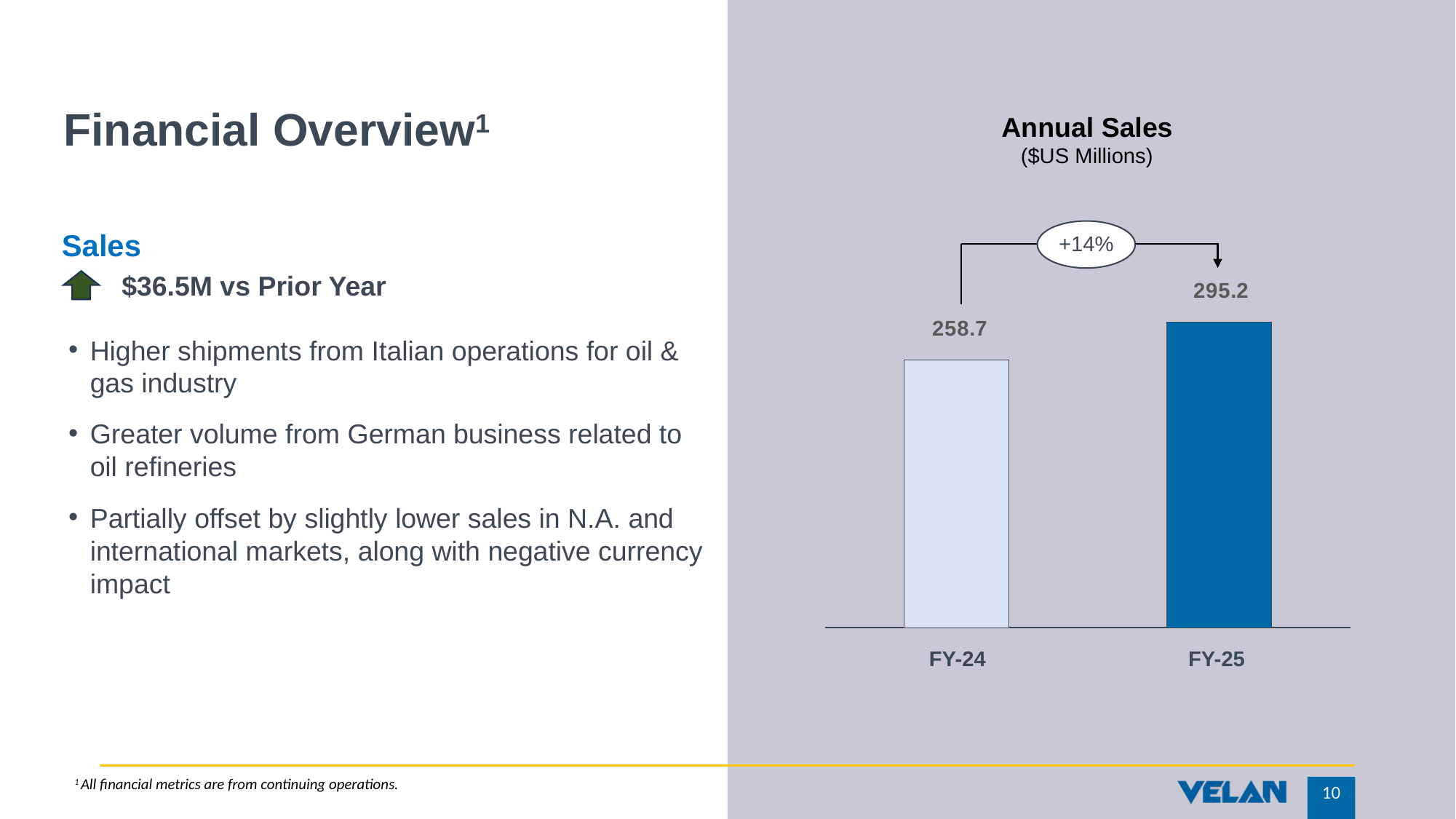
What is the Annual Sales value for FY-25? 295.2 How many years are shown in the Annual Sales chart? 2 What kind of chart is the Annual Sales chart? bar chart Which year has the lower Annual Sales? FY-24 What unit is the Annual Sales chart measured in? $US Millions Do Annual Sales rise or fall from FY-24 to FY-25? rise What is the difference in Annual Sales between FY-25 and FY-24? 36.5 What is the Annual Sales value for FY-24? 258.7 Which year has the higher Annual Sales? FY-25 What percentage change is shown between FY-24 and FY-25 in the Annual Sales chart? +14% Is the Annual Sales value for FY-25 larger or smaller than the value for FY-24? larger